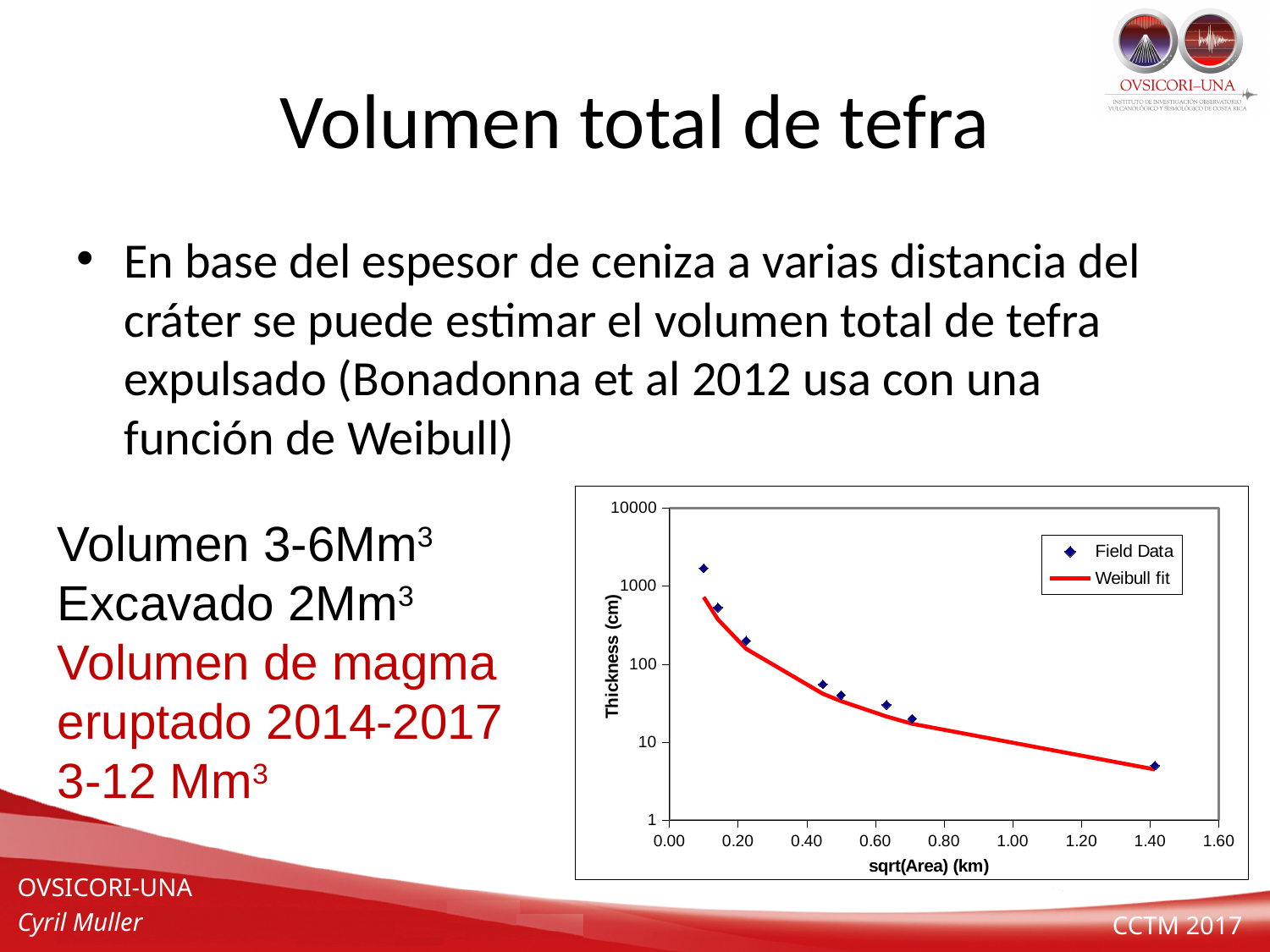
Which Field Data point has the highest thickness: the one at the smallest sqrt(Area) or the one at the largest sqrt(Area)? The one at the smallest sqrt(Area) What is the label of the chart's y axis? Thickness (cm) What is the maximum value shown on the chart's x axis? 1.60 Does the thickness rise or fall as sqrt(Area) increases along the x axis? Fall Is the thickness of the Field Data point nearest sqrt(Area) = 0.10 km greater or less than 1000 cm? greater Is the thickness of the Field Data point at sqrt(Area) of about 1.40 km greater or less than 10 cm? less How many series does the chart legend list? 2 What kind of chart is shown on the slide? Scatter chart with a fitted line Is the thickness of the Field Data point near sqrt(Area) = 0.70 km greater or less than 100 cm? less What are the two series named in the chart legend? Field Data and Weibull fit